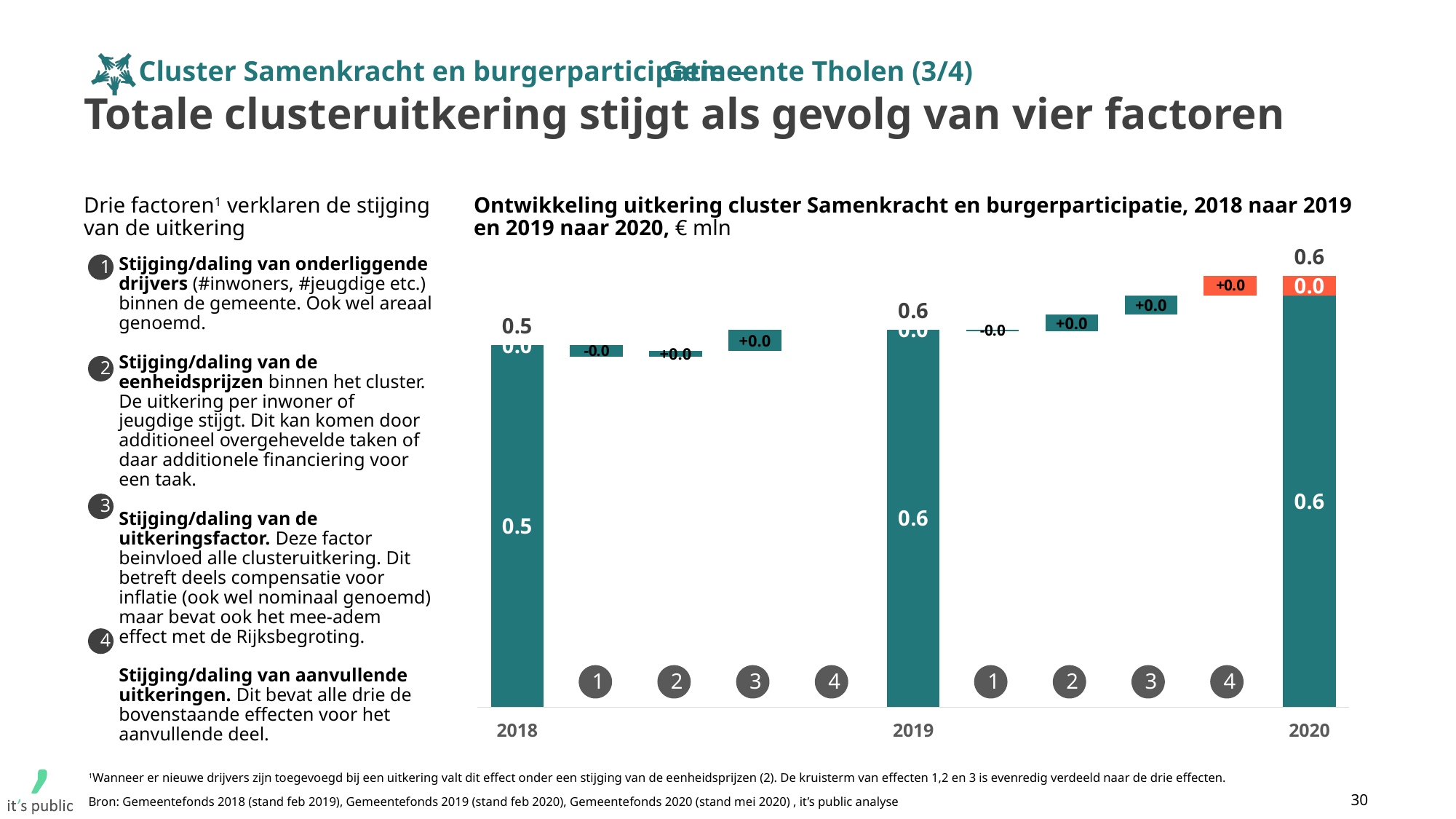
What is the value of the teal (lower) segment of the 2020 bar? 0.6 Which year has the lowest total uitkering in the chart? 2018 What is the total value shown above the 2018 bar? 0.5 Does the total uitkering rise or fall from 2018 to 2020? Rise What is the value of the orange (upper) segment of the 2018 bar? 0.0 What is the difference between the 2019 total and the 2018 total? 0.1 What kind of chart is shown on the slide? Bar chart (waterfall) What is the total value shown above the 2020 bar? 0.6 In what unit are the values in the chart expressed, according to the chart title? € mln How many year totals (2018, 2019, 2020) are shown in the chart? 3 What is the total value shown above the 2019 bar? 0.6 Is the total for 2018 or for 2019 larger? 2019